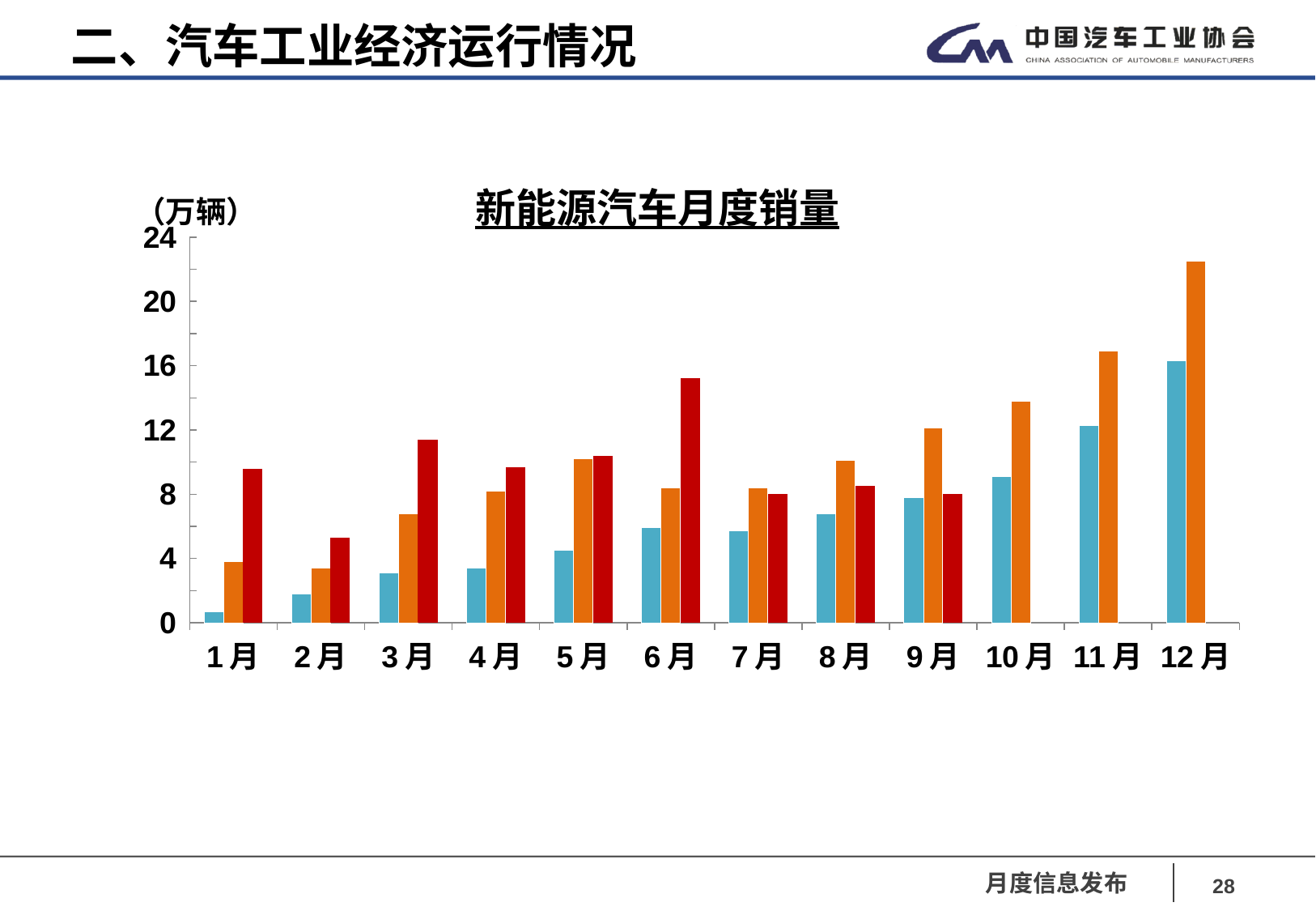
What unit is shown at the top of the y axis? 万辆 Do the blue bars generally rise or fall from 1月 to 12月? rise In which month is the orange bar the highest? 12月 In which month is the red bar the highest? 6月 What is the title of the chart? 新能源汽车月度销量 Is the value of the red bar for 6月 greater or less than 12? greater Is the value of the blue bar for 1月 greater or less than 4? less In which month is the blue bar the lowest? 1月 What kind of chart is shown on the slide? bar chart For 3月, which is larger: the red bar or the orange bar? the red bar How many months are shown on the x axis of the chart? 12 Is the value of the orange bar for 12月 greater or less than 20? greater